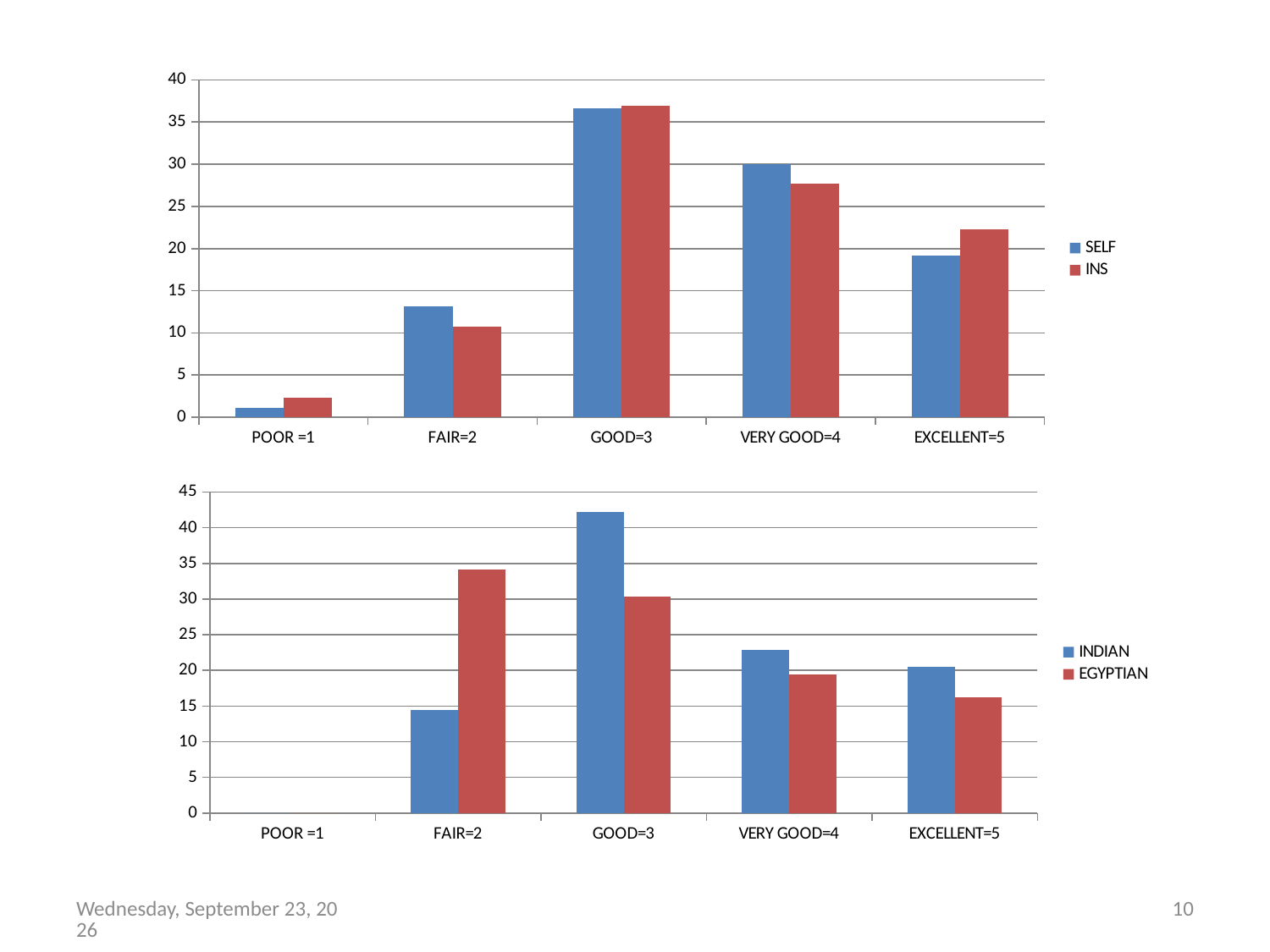
In the bottom chart, for FAIR=2, which is larger, INDIAN or EGYPTIAN? EGYPTIAN In the bottom chart, is the EGYPTIAN value for EXCELLENT=5 greater or less than 20? less In the top chart, which category has the highest SELF value? GOOD=3 In the top chart, for EXCELLENT=5, which is larger, SELF or INS? INS How many categories are shown on the x axis of the top chart? 5 What kind of chart is the top chart on the slide? bar chart In the bottom chart, is the INDIAN value for GOOD=3 greater or less than 40? greater In the top chart, is the SELF value for FAIR=2 greater or less than 10? greater What are the two legend entries in the bottom chart? INDIAN and EGYPTIAN In the top chart, how many series does the legend list? 2 In the top chart, which category has the lowest INS value? POOR =1 In the bottom chart, which category has the highest INDIAN value? GOOD=3